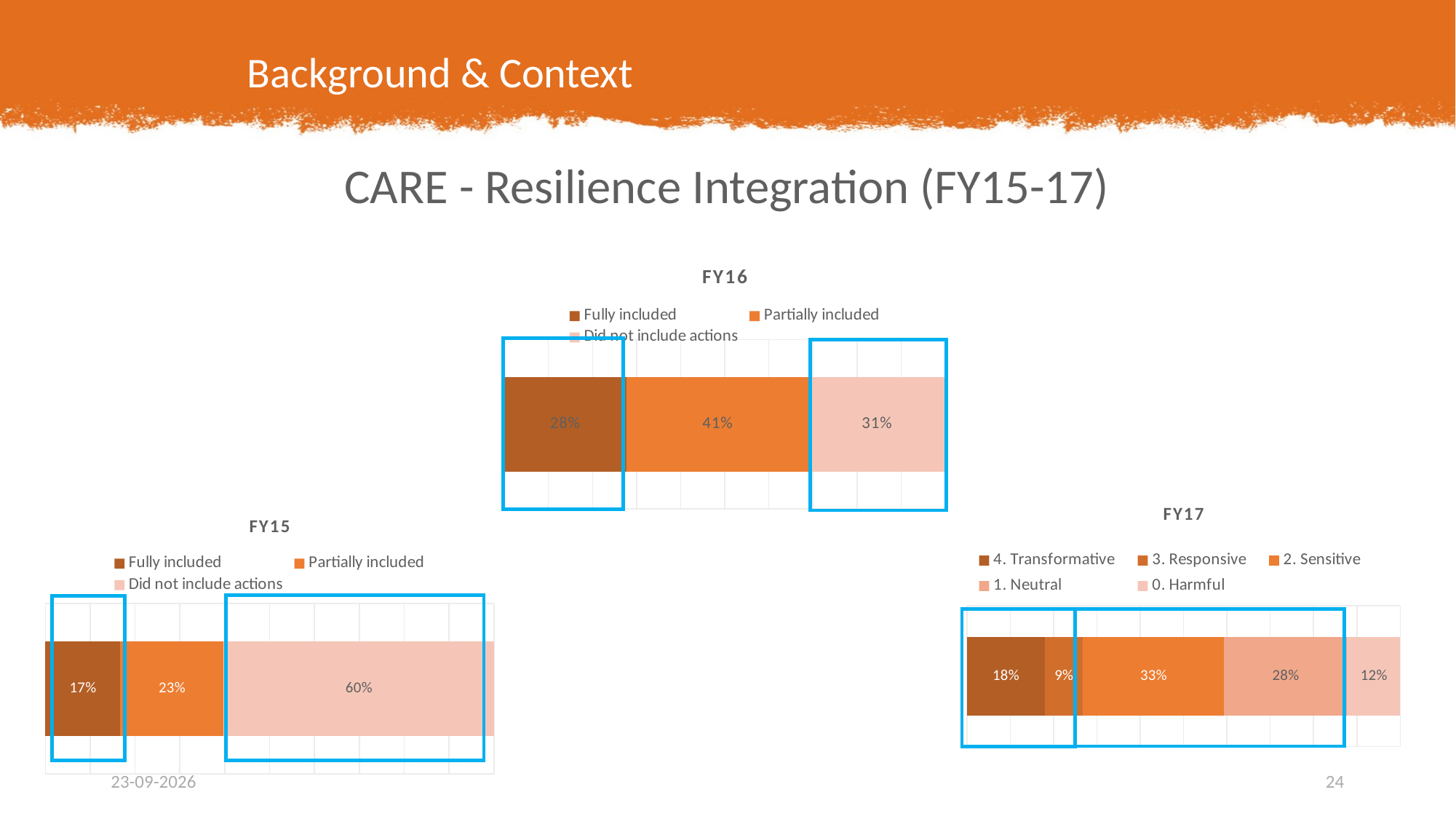
In the FY17 chart, which category has the lowest value? 3. Responsive In the FY16 chart, which is larger, Fully included or Did not include actions? Did not include actions In the FY17 chart, what is the value for 0. Harmful? 12% How many series does the legend of the FY15 chart list? 3 In the FY17 chart, what is the total of 4. Transformative and 3. Responsive? 27% In the FY16 chart, which category has the highest value? Partially included In the FY15 chart, what is the value for Did not include actions? 60% In the FY17 chart, what is the value for 2. Sensitive? 33% What kind of chart is the FY16 chart? Stacked bar chart How many series does the legend of the FY17 chart list? 5 In the FY16 chart, what is the value for Partially included? 41% In the FY15 chart, what is the difference between Did not include actions and Fully included? 43%